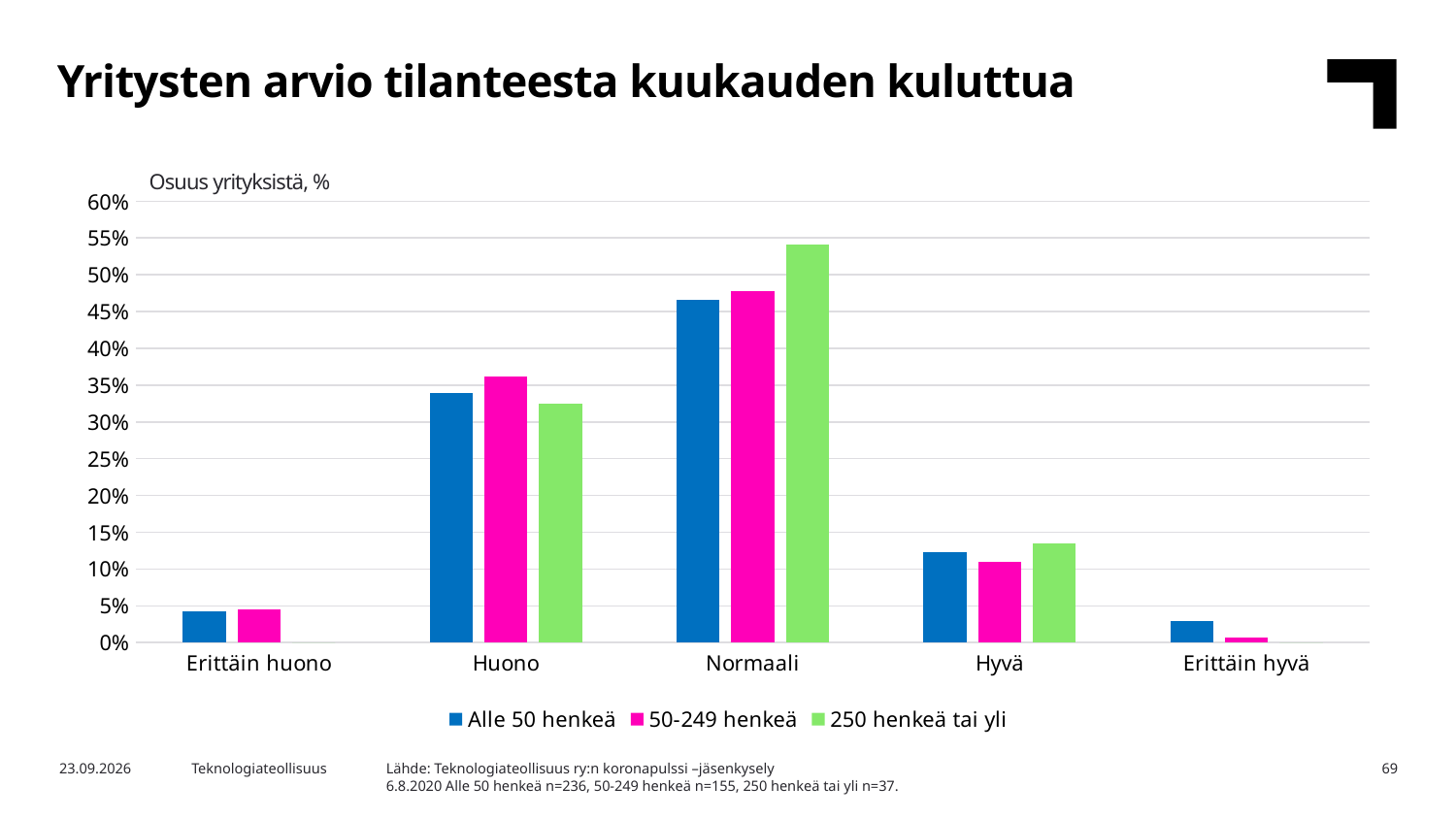
In the 'Huono' category, which is larger: the value for '50-249 henkeä' or for '250 henkeä tai yli'? 50-249 henkeä Is the value for '250 henkeä tai yli' in the 'Normaali' category greater or less than 50%? greater How many categories are shown on the x axis? 5 Is the value for 'Alle 50 henkeä' in the 'Huono' category greater or less than 30%? greater Is the value for 'Alle 50 henkeä' in the 'Normaali' category greater or less than 40%? greater What is the label shown above the vertical axis of the chart? Osuus yrityksistä, % In the 'Erittäin hyvä' category, which is larger: the value for 'Alle 50 henkeä' or for '50-249 henkeä'? Alle 50 henkeä In the 'Normaali' category, which series has the highest bar? 250 henkeä tai yli What kind of chart is shown on the slide? bar chart How many series does the legend list? 3 For the series '250 henkeä tai yli', which category has the highest value? Normaali